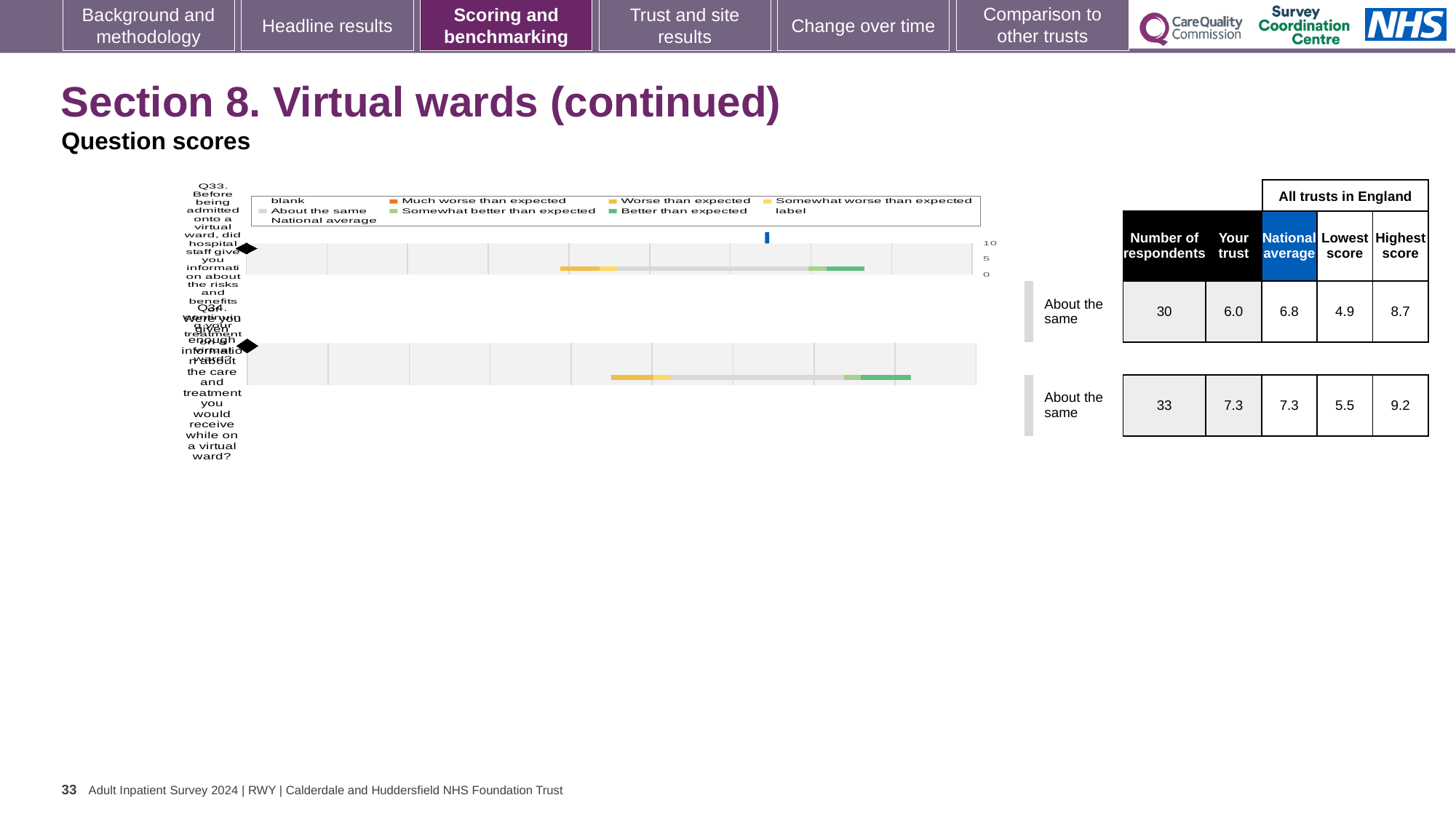
What is the highest score among all trusts in England for Q34? 9.2 What benchmark category is shown next to the Q34 bar? About the same What kind of chart is shown on the slide? bar chart What is the lowest score among all trusts in England for Q33? 4.9 What is the difference between the highest and lowest scores for Q34? 3.7 How many questions (bars) are plotted in the chart? 2 According to the table, how many respondents answered Q33? 30 For Q33, which is larger: the 'Your trust' score or the national average? National average What is the 'Your trust' score for Q33? 6.0 Which question has the higher 'Your trust' score, Q33 or Q34? Q34 What is the national average score for Q34? 7.3 What is the difference between the national average and the 'Your trust' score for Q33? 0.8